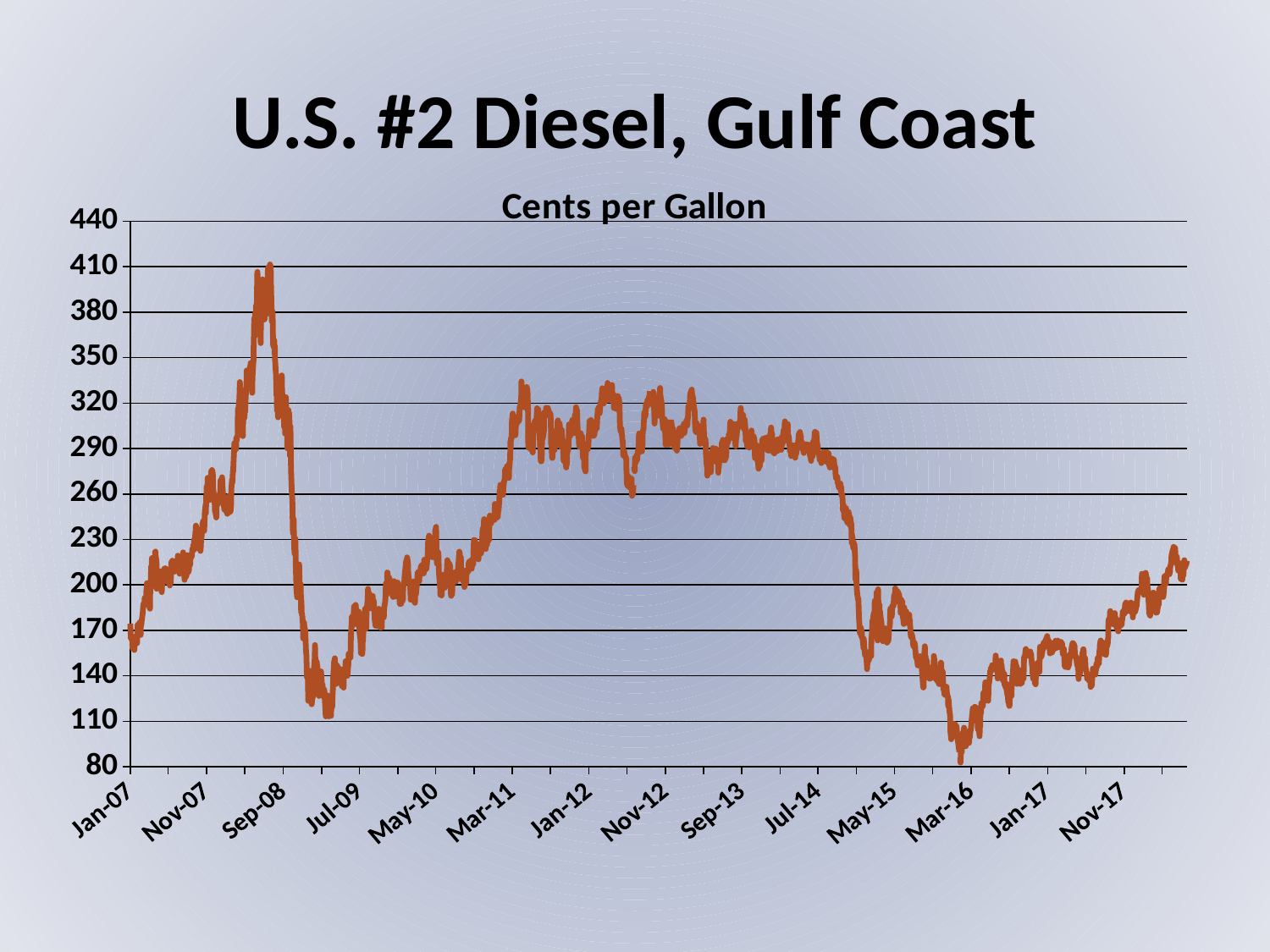
How many date labels are shown along the x axis? 14 Around which x-axis label does the line reach its highest value? Sep-08 Does the line rise or fall between Sep-08 and Jul-09? fall Is the peak value near Sep-08 greater or less than 380? greater How many lines (data series) are plotted on the chart? 1 Which is larger, the value around Jan-12 or the value around Jan-17? Jan-12 What is the title of the chart? Cents per Gallon What unit is the chart's data measured in, according to the label above the plot area? Cents per Gallon Is the lowest value near Mar-16 greater or less than 110? less Around which x-axis label does the line reach its lowest value? Mar-16 What kind of chart is shown on the slide? line chart Is the value at Jan-12 greater or less than 260? greater